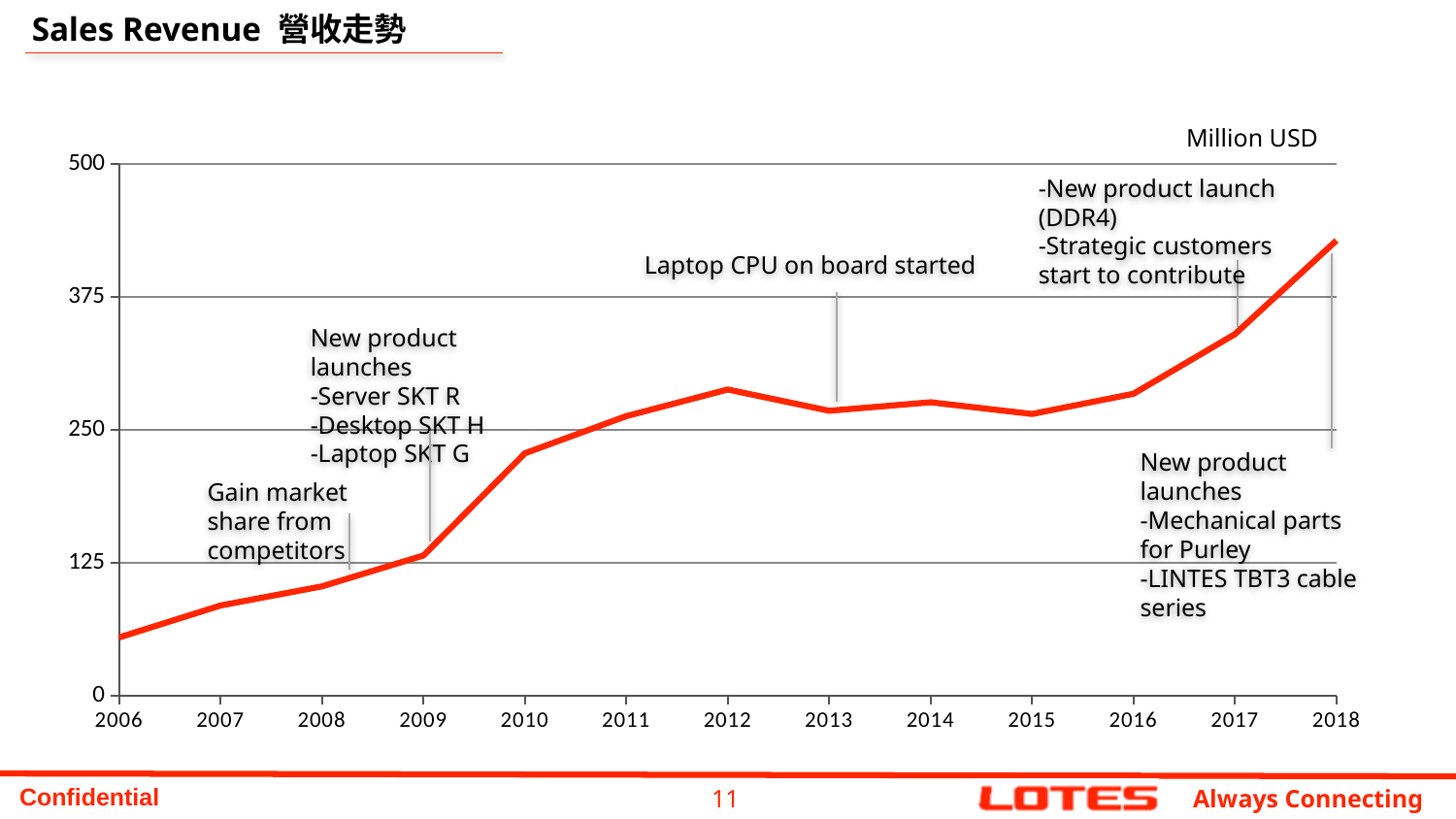
Which year has higher sales revenue, 2008 or 2010? 2010 Which year has the highest sales revenue on the chart? 2018 How many years are plotted along the x axis of the Sales Revenue chart? 13 Is the sales revenue for 2006 greater or less than 125? less Which year has the lowest sales revenue on the chart? 2006 In what unit is sales revenue shown on the chart? Million USD Does sales revenue generally rise or fall from 2006 to 2018? rise Is the sales revenue for 2010 greater or less than 250? less Is the sales revenue for 2017 greater or less than 375? less What kind of chart is shown on the slide? line chart